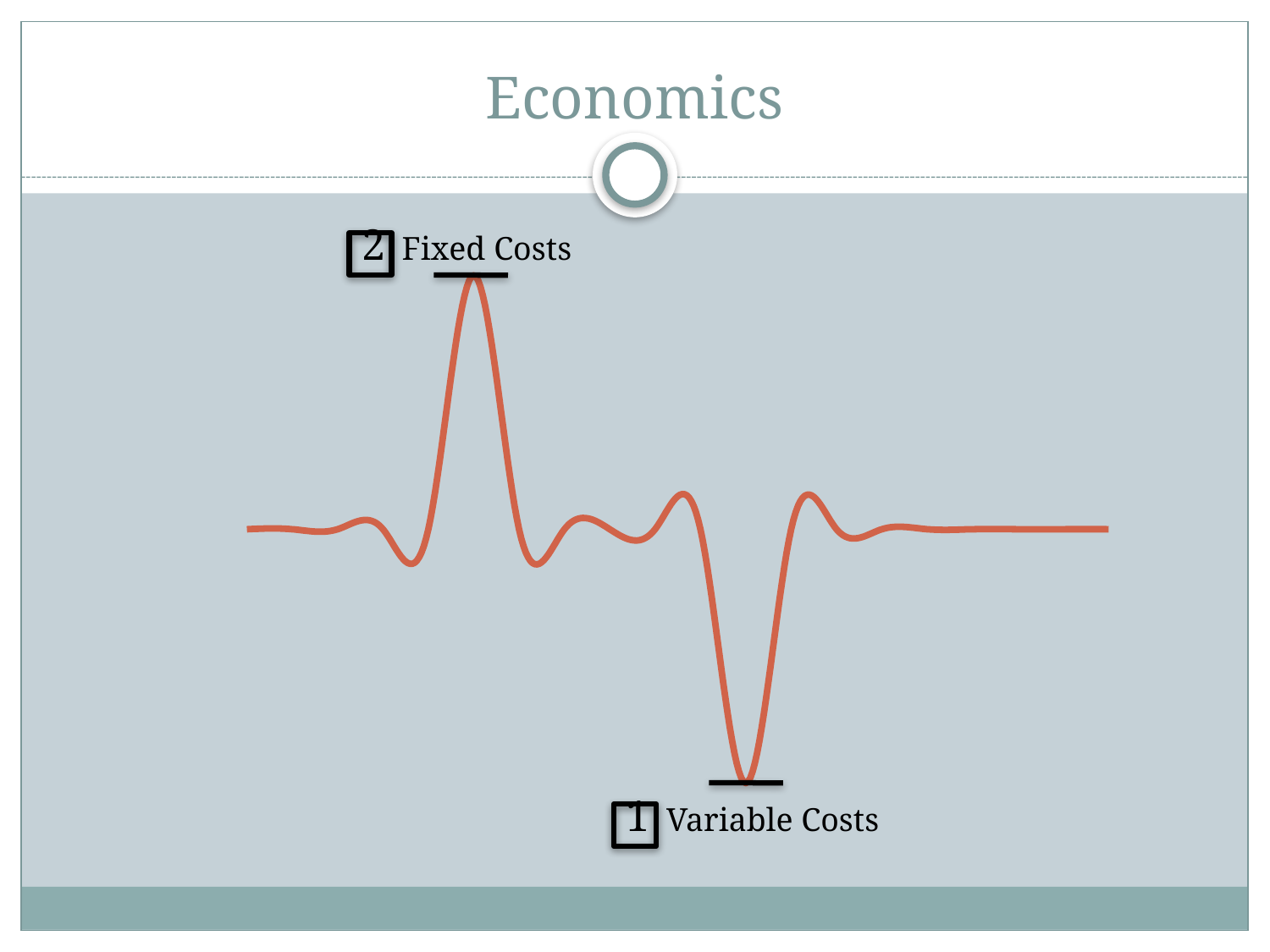
What is the title of the slide containing the chart? Economics Which number is shown in the box next to the Variable Costs label? 1 Is the point labeled Fixed Costs higher or lower on the curve than the point labeled Variable Costs? Higher What kind of chart is shown on the slide? Line chart How many labeled points are marked on the curve? 2 Which number is shown in the box next to the Fixed Costs label? 2 Which labeled point on the curve is the highest? Fixed Costs What colour is the plotted line? Orange-red Which labeled point on the curve is the lowest? Variable Costs